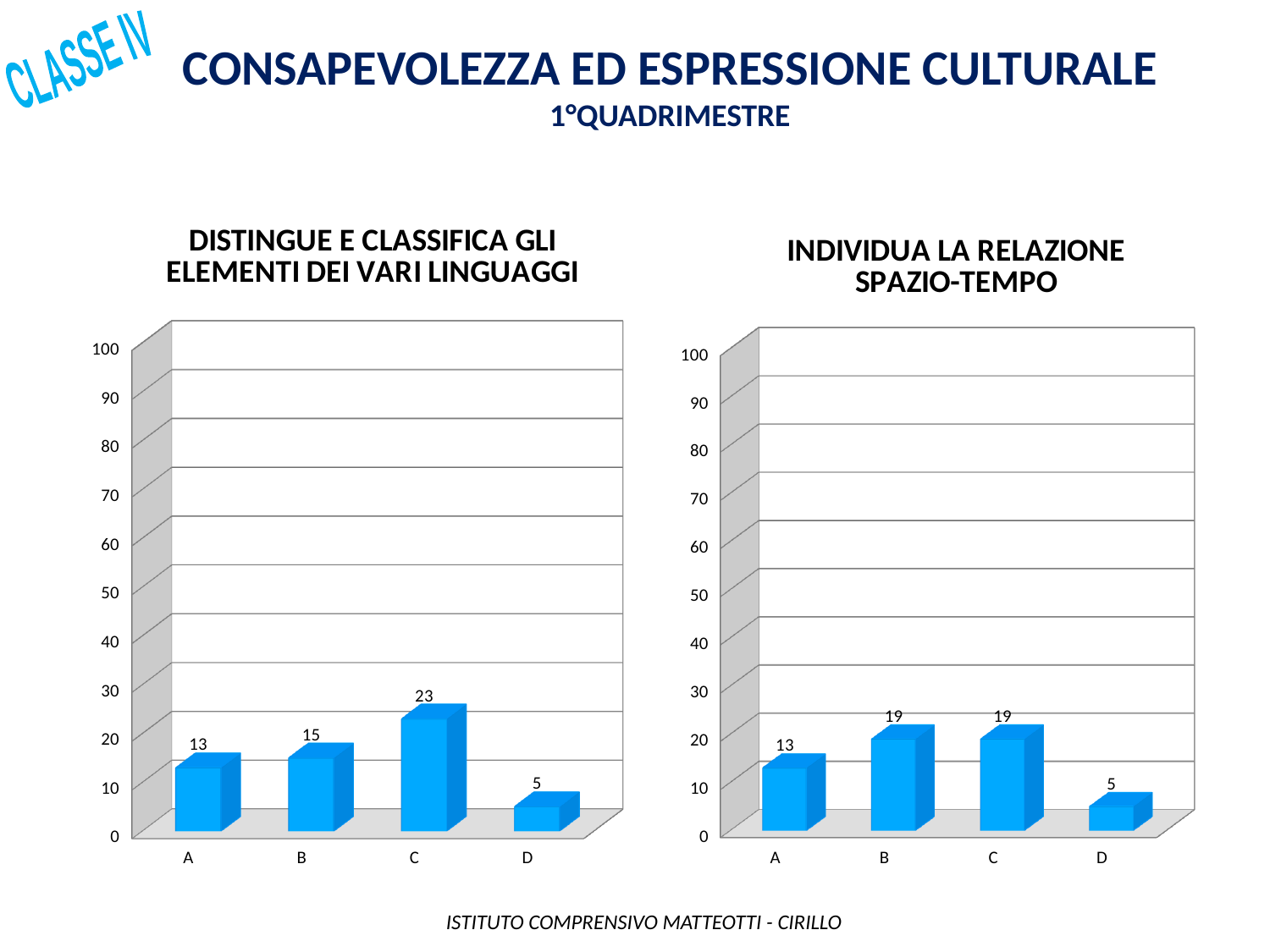
In the left chart, which is larger, the value for B or the value for D? B In the left chart, what is the difference between the values for C and A? 10 In the right chart, which category has the lowest value? D In the right chart, is the value for C greater or less than 10? greater In the chart titled "INDIVIDUA LA RELAZIONE SPAZIO-TEMPO", what is the value for category A? 13 How many categories are shown on the x axis of the right chart? 4 What kind of chart is the left chart? bar chart In the chart titled "DISTINGUE E CLASSIFICA GLI ELEMENTI DEI VARI LINGUAGGI", what is the value for category C? 23 In the right chart, what is the difference between the values for B and D? 14 In the right chart, what is the value for category B? 19 What is the title of the right chart? INDIVIDUA LA RELAZIONE SPAZIO-TEMPO In the left chart, which category has the highest value? C